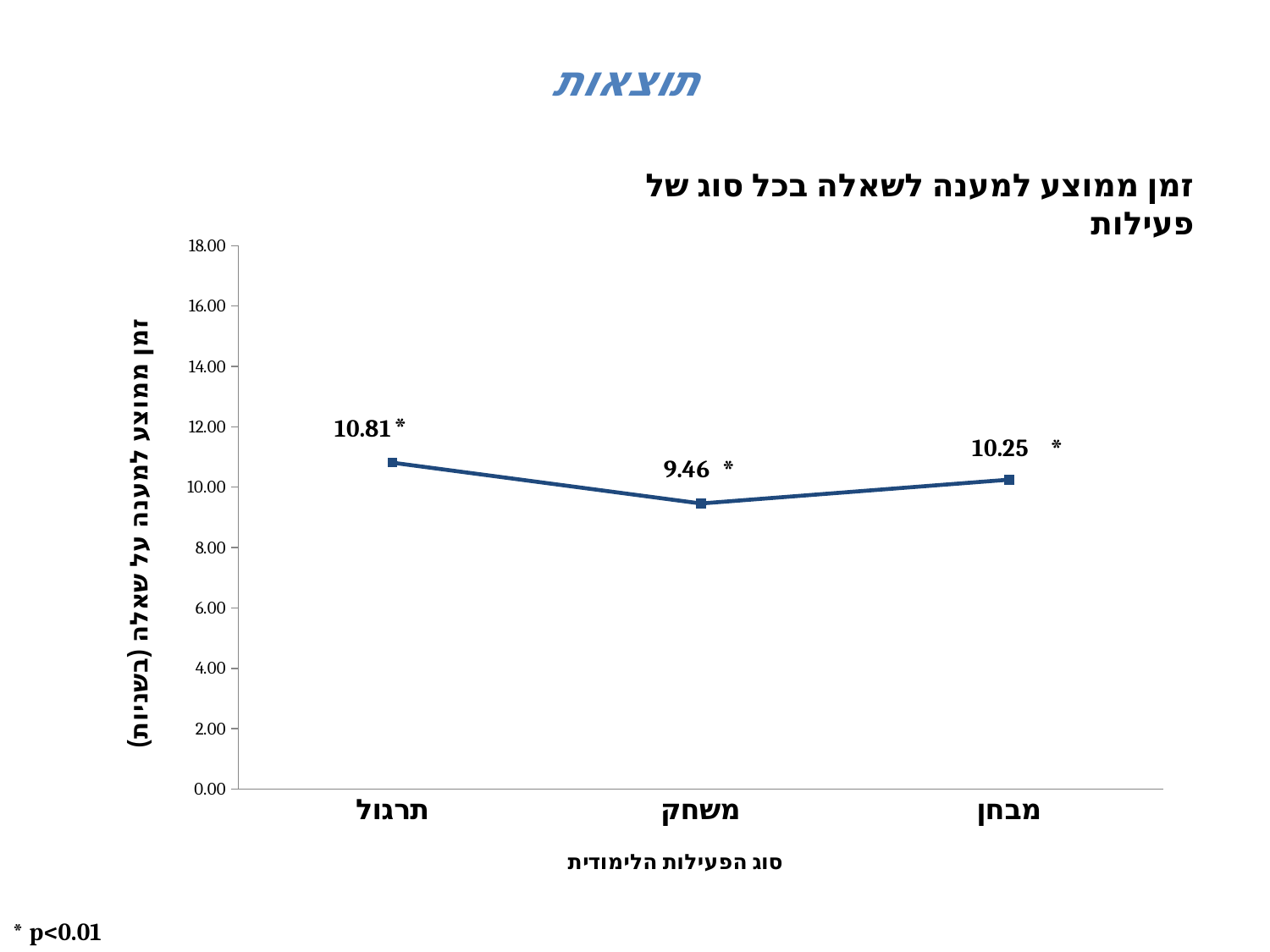
What is the value for משחק? 9.46 Is the value for משחק greater or less than 10.00? less What is the title of the chart? זמן ממוצע למענה לשאלה בכל סוג של פעילות What is the value for מבחן? 10.25 What is the value for תרגול? 10.81 What is the difference between the values for תרגול and משחק? 1.35 Which category has the lowest value? משחק What kind of chart is shown on the slide? line chart What is the difference between the values for תרגול and מבחן? 0.56 Which is larger, the value for מבחן or the value for משחק? מבחן How many categories are shown on the x axis? 3 Which category has the highest value? תרגול